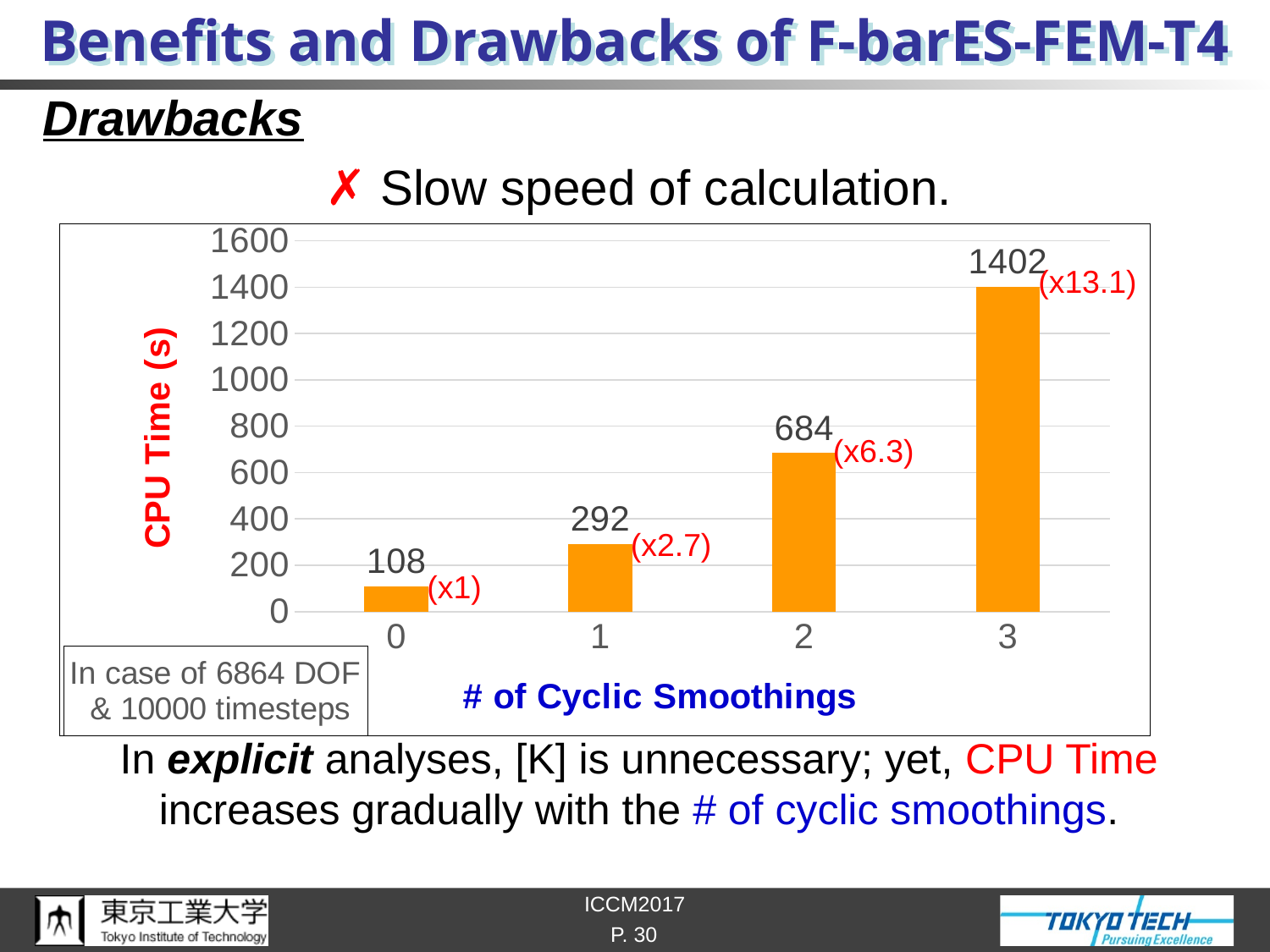
What is the CPU Time (s) for 3 cyclic smoothings? 1402 What is the CPU Time (s) for 0 cyclic smoothings? 108 How many bars are plotted in the chart? 4 Is the CPU Time for 1 cyclic smoothing greater or less than 400? less What is the difference in CPU Time (s) between 3 and 2 cyclic smoothings? 718 Which has a larger CPU Time, 1 cyclic smoothing or 2 cyclic smoothings? 2 cyclic smoothings What is the CPU Time (s) for 2 cyclic smoothings? 684 Which number of cyclic smoothings has the lowest CPU Time? 0 What is the difference in CPU Time (s) between 1 and 0 cyclic smoothings? 184 Which number of cyclic smoothings has the highest CPU Time? 3 What kind of chart is shown on the slide? bar chart Does CPU Time rise or fall as the number of cyclic smoothings increases? rise